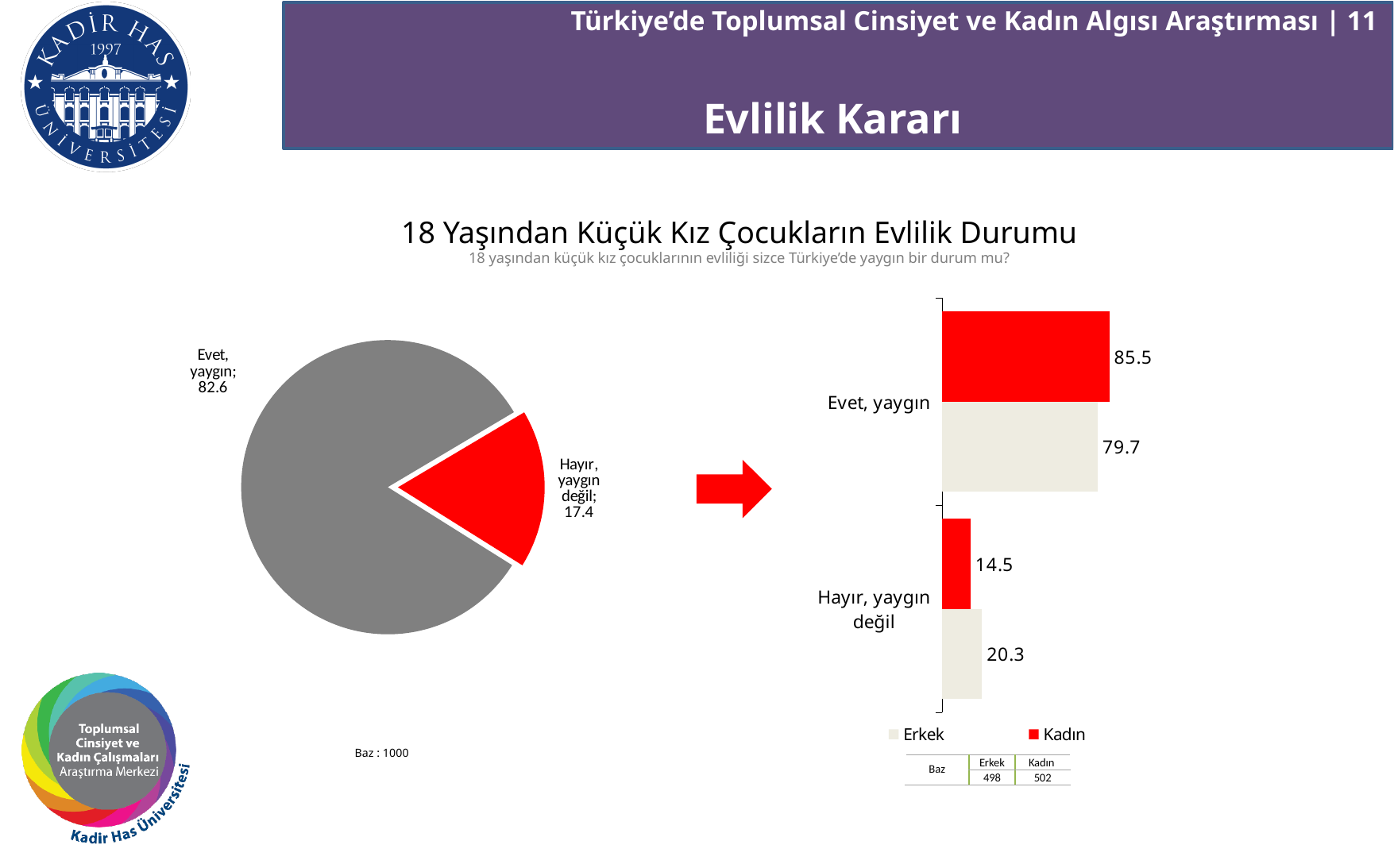
In the bar chart on the right, which is larger for "Hayır, yaygın değil": the Erkek value or the Kadın value? Erkek In the bar chart on the right, what is the difference between the Kadın and Erkek values for "Evet, yaygın"? 5.8 In the bar chart on the right, what is the Kadın value for "Evet, yaygın"? 85.5 What type of chart is shown on the right side of the slide? Bar chart In the pie chart on the left, how many slices are there? 2 In the bar chart on the right, what is the Kadın value for "Hayır, yaygın değil"? 14.5 In the bar chart on the right, how many series does the legend list? 2 In the bar chart on the right, what is the Erkek value for "Hayır, yaygın değil"? 20.3 In the pie chart on the left, which slice is the largest? Evet, yaygın In the bar chart on the right, what is the Erkek value for "Evet, yaygın"? 79.7 In the pie chart on the left, what is the value for "Hayır, yaygın değil"? 17.4 In the pie chart on the left, what is the value for "Evet, yaygın"? 82.6